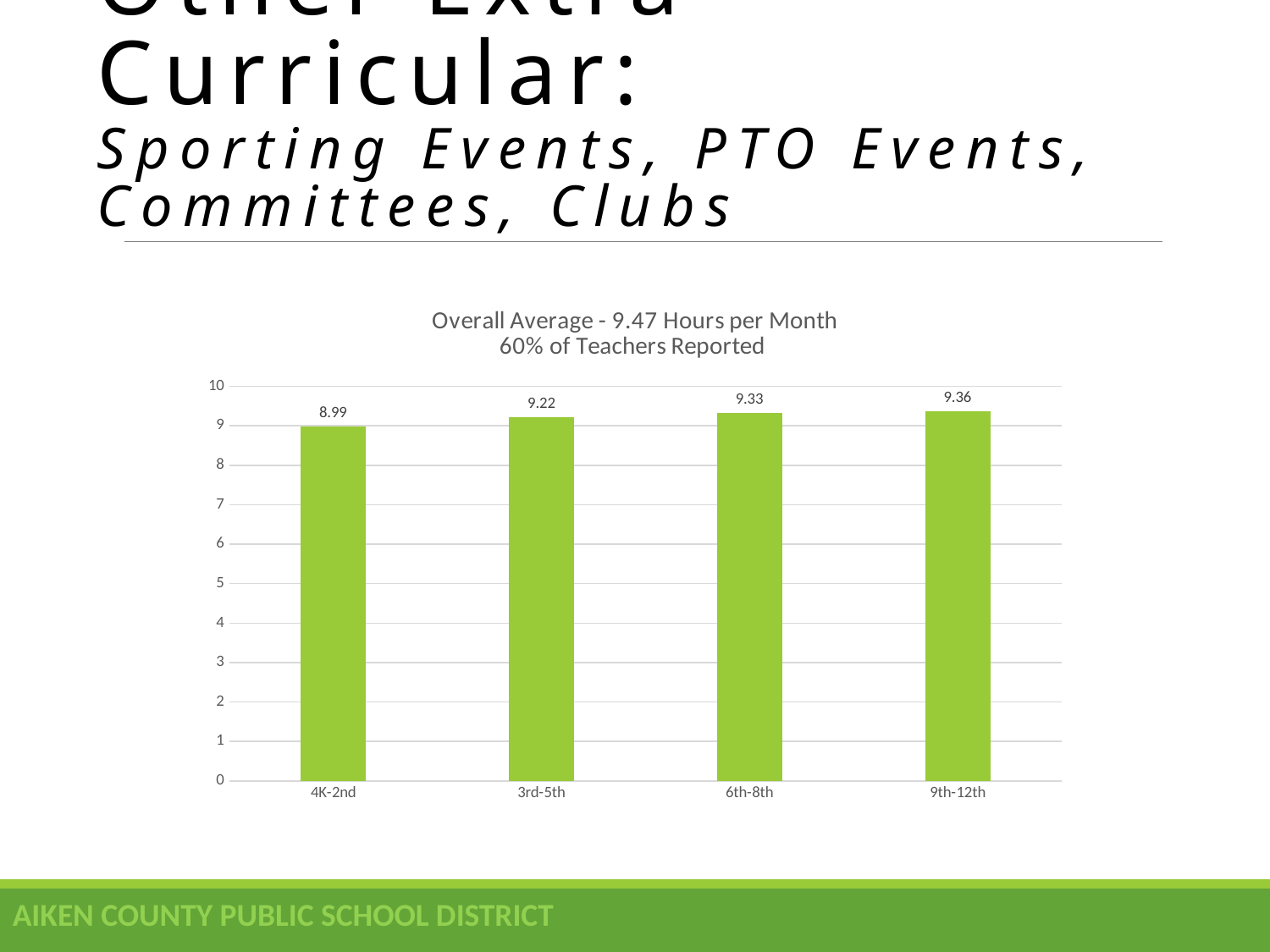
Do the values rise or fall from 4K-2nd to 9th-12th? rise What is the value for 3rd-5th? 9.22 What is the value for 9th-12th? 9.36 Which grade band has the highest value? 9th-12th Is the value for 4K-2nd greater or less than 9? less What is the value for 6th-8th? 9.33 Which is larger, the value for 3rd-5th or the value for 4K-2nd? 3rd-5th What is the value for 4K-2nd? 8.99 What kind of chart is shown on the slide? bar chart How many grade bands are shown on the chart? 4 Which grade band has the lowest value? 4K-2nd What is the difference between the values for 9th-12th and 4K-2nd? 0.37